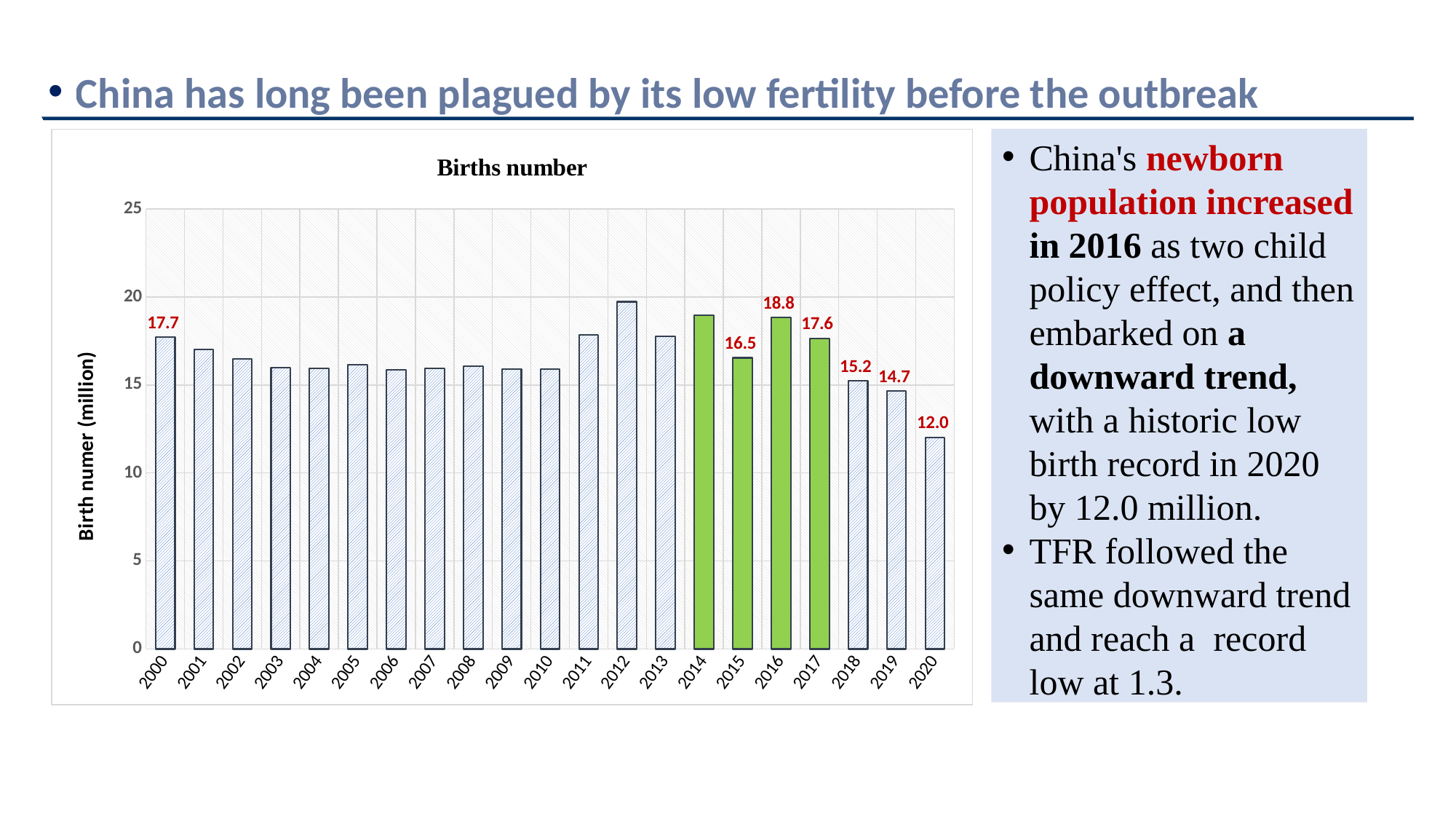
What is the births number for 2020? 12.0 How many years are shown on the x axis of the chart? 21 What is the difference between the births number in 2016 and in 2020? 6.8 What is the difference between the births number in 2018 and in 2019? 0.5 What kind of chart is shown on the slide? bar chart Which year has the lowest births number? 2020 Which year has the highest births number? 2012 Do the births numbers rise or fall from 2016 to 2020? fall Which year has a larger births number, 2015 or 2017? 2017 Is the births number for 2012 greater or less than 15? greater What is the births number for 2016? 18.8 What is the births number for 2000? 17.7